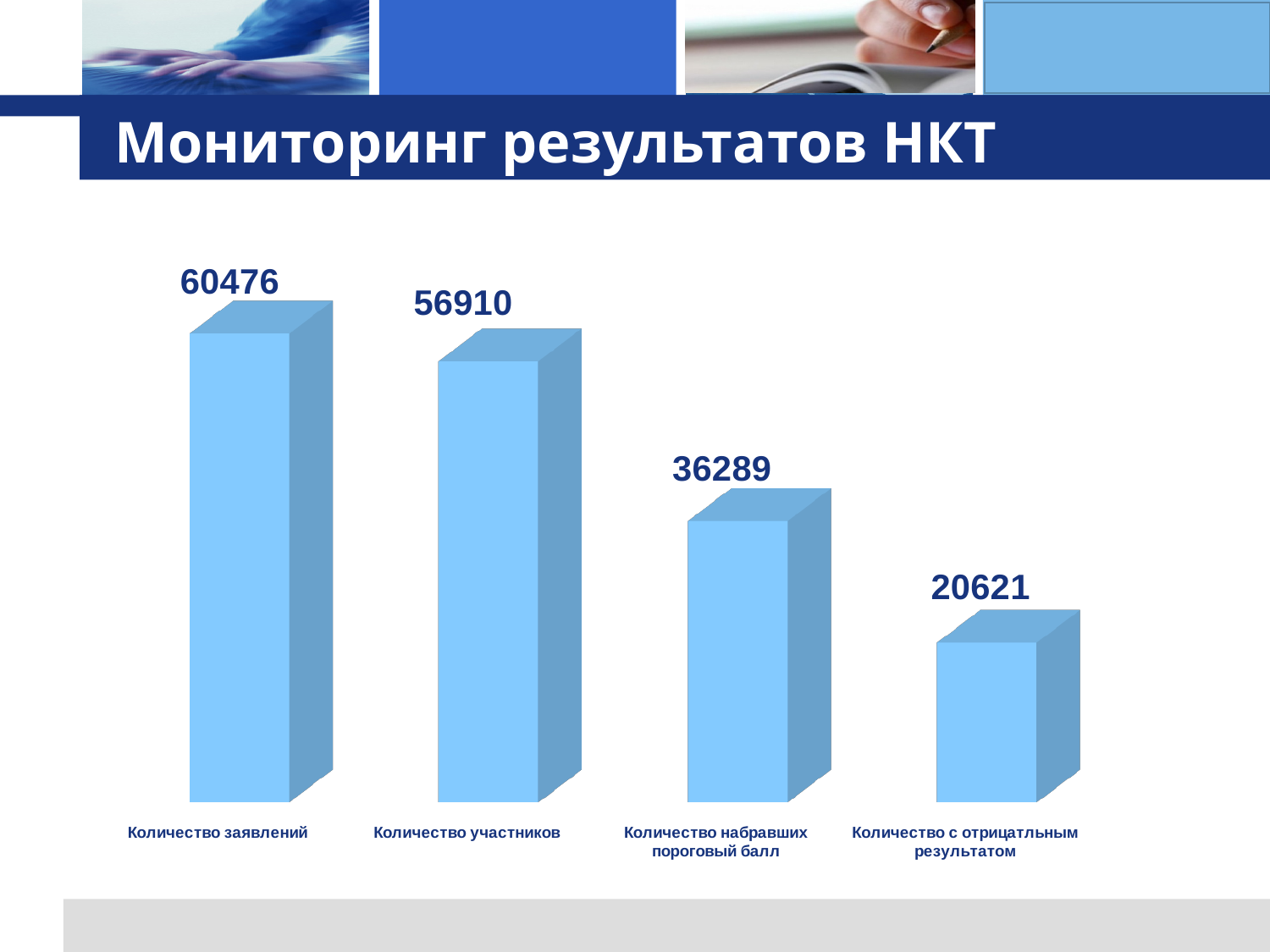
What is the difference between Количество заявлений and Количество участников? 3566 Which is larger: Количество участников or Количество набравших пороговый балл? Количество участников What is the difference between Количество набравших пороговый балл and Количество с отрицатльным результатом? 15668 How many categories are shown in the chart? 4 Which category has the highest value? Количество заявлений Which category has the lowest value? Количество с отрицатльным результатом What is the value for Количество заявлений? 60476 Do the values rise or fall from left to right across the categories? Fall What is the value for Количество участников? 56910 What kind of chart is shown on the slide? Bar chart What is the value for Количество с отрицатльным результатом? 20621 What is the value for Количество набравших пороговый балл? 36289